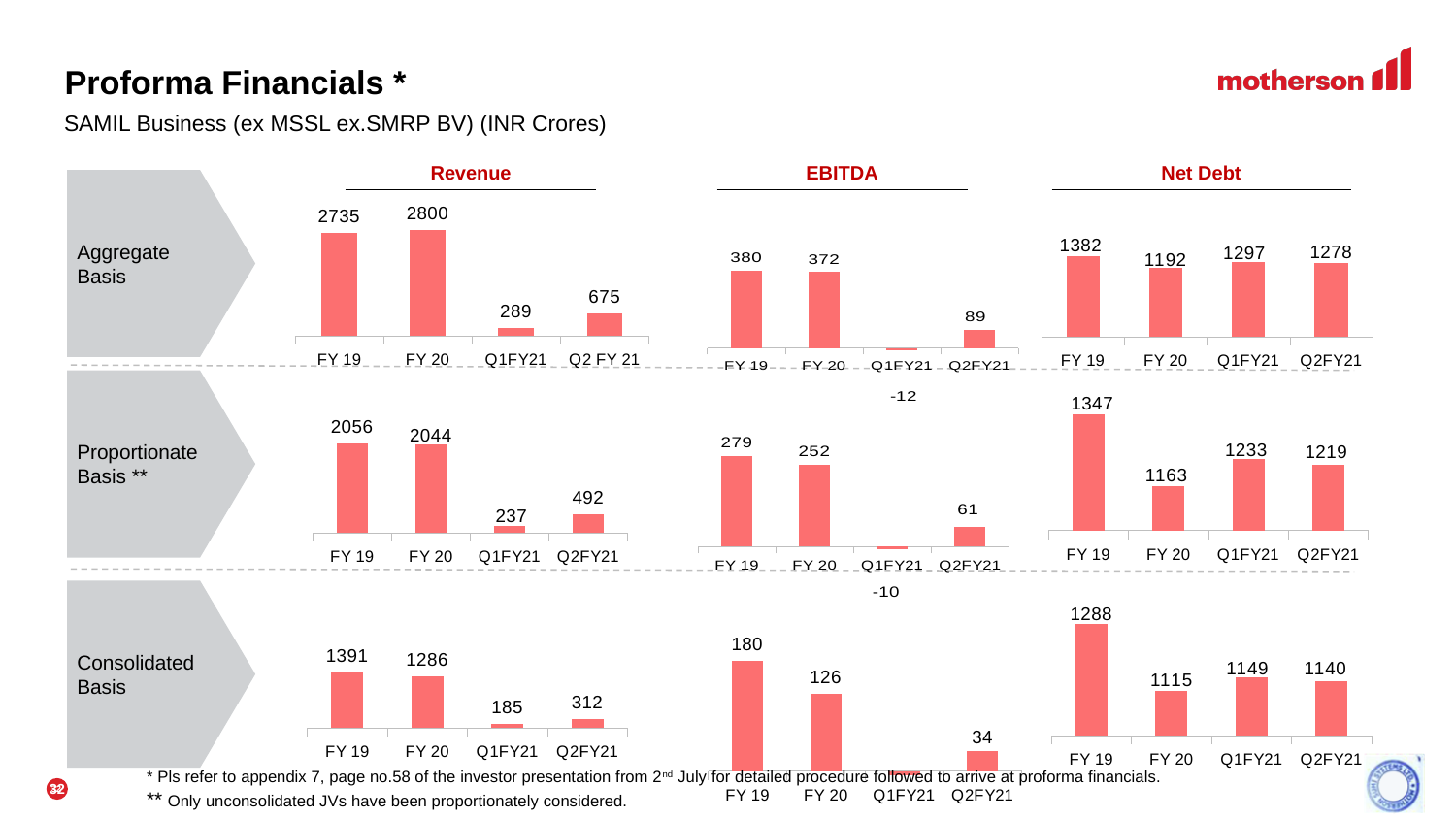
What are the three column headings above the charts on the slide? Revenue, EBITDA, Net Debt What kind of chart is used for the Consolidated Basis Net Debt data? Bar chart In the Aggregate Basis Revenue chart, what is the difference between the FY 20 and FY 19 values? 65 In the Proportionate Basis Net Debt chart, which is larger, Q1FY21 or Q2FY21? Q1FY21 In the Aggregate Basis Net Debt chart, which period has the highest value? FY 19 In the Consolidated Basis Net Debt chart, does the value rise or fall from FY 19 to FY 20? Fall In the Consolidated Basis Revenue chart, which period has the lowest value? Q1FY21 In the Proportionate Basis Revenue chart, what is the difference between the FY 19 and Q2FY21 values? 1564 In the Consolidated Basis EBITDA chart, what is the value for Q2FY21? 34 In the Proportionate Basis EBITDA chart, what is the value for Q1FY21? -10 How many bars are plotted in the Aggregate Basis EBITDA chart? 4 In the Aggregate Basis Revenue chart, what is the value for FY 20? 2800